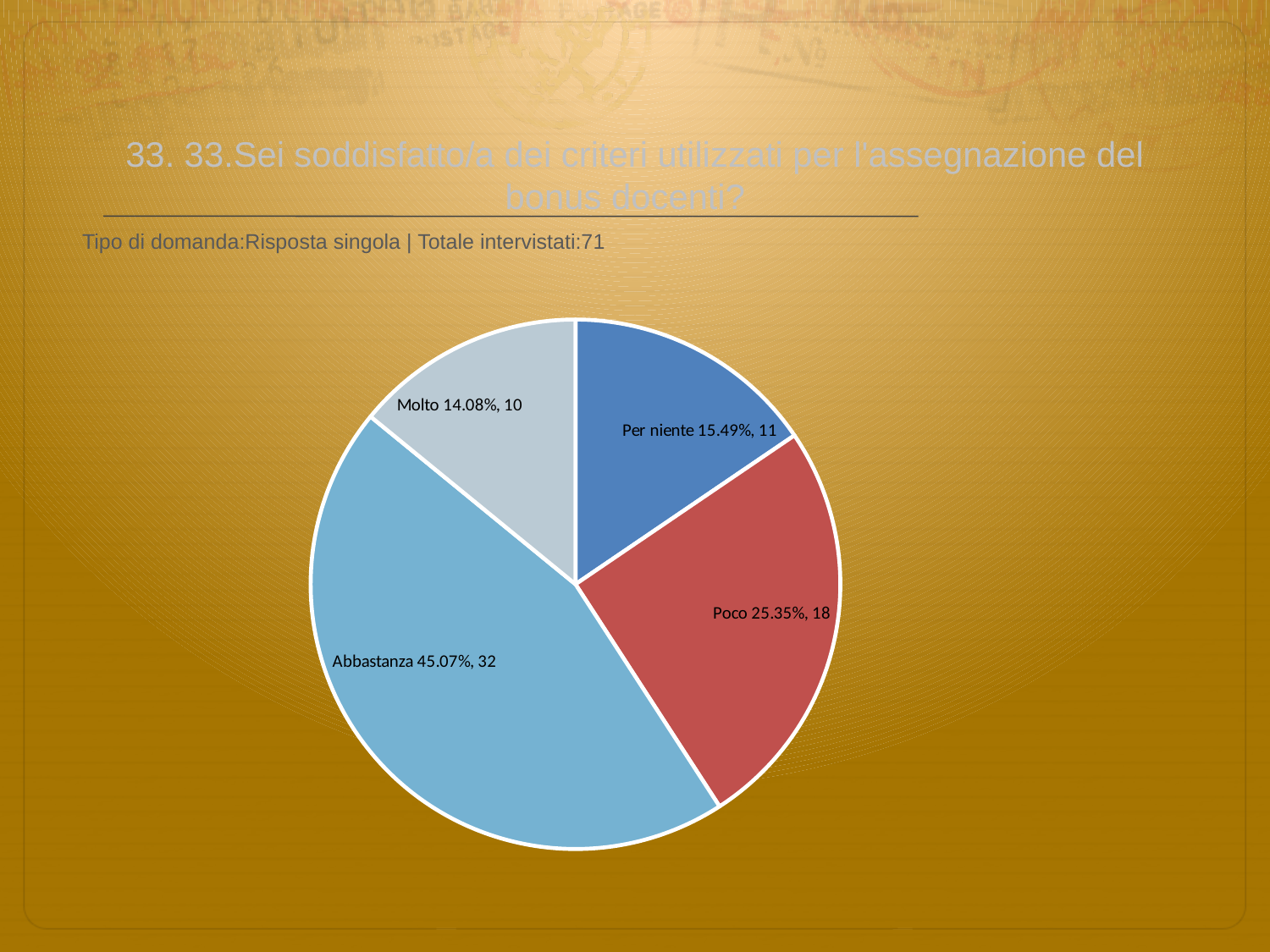
What percentage share does the 'Per niente' slice have? 15.49% What colour is the 'Poco' slice? red How many respondents answered 'Molto'? 10 Which category has the largest slice? Abbastanza How many respondents answered 'Poco'? 18 What is the difference in respondent count between 'Abbastanza' and 'Poco'? 14 What percentage share does the 'Abbastanza' slice have? 45.07% Which category has the smallest slice? Molto Which has more respondents, 'Per niente' or 'Molto'? Per niente How many slices does the pie chart have? 4 What is the total number of respondents shown on the slide? 71 What kind of chart is shown on the slide? pie chart